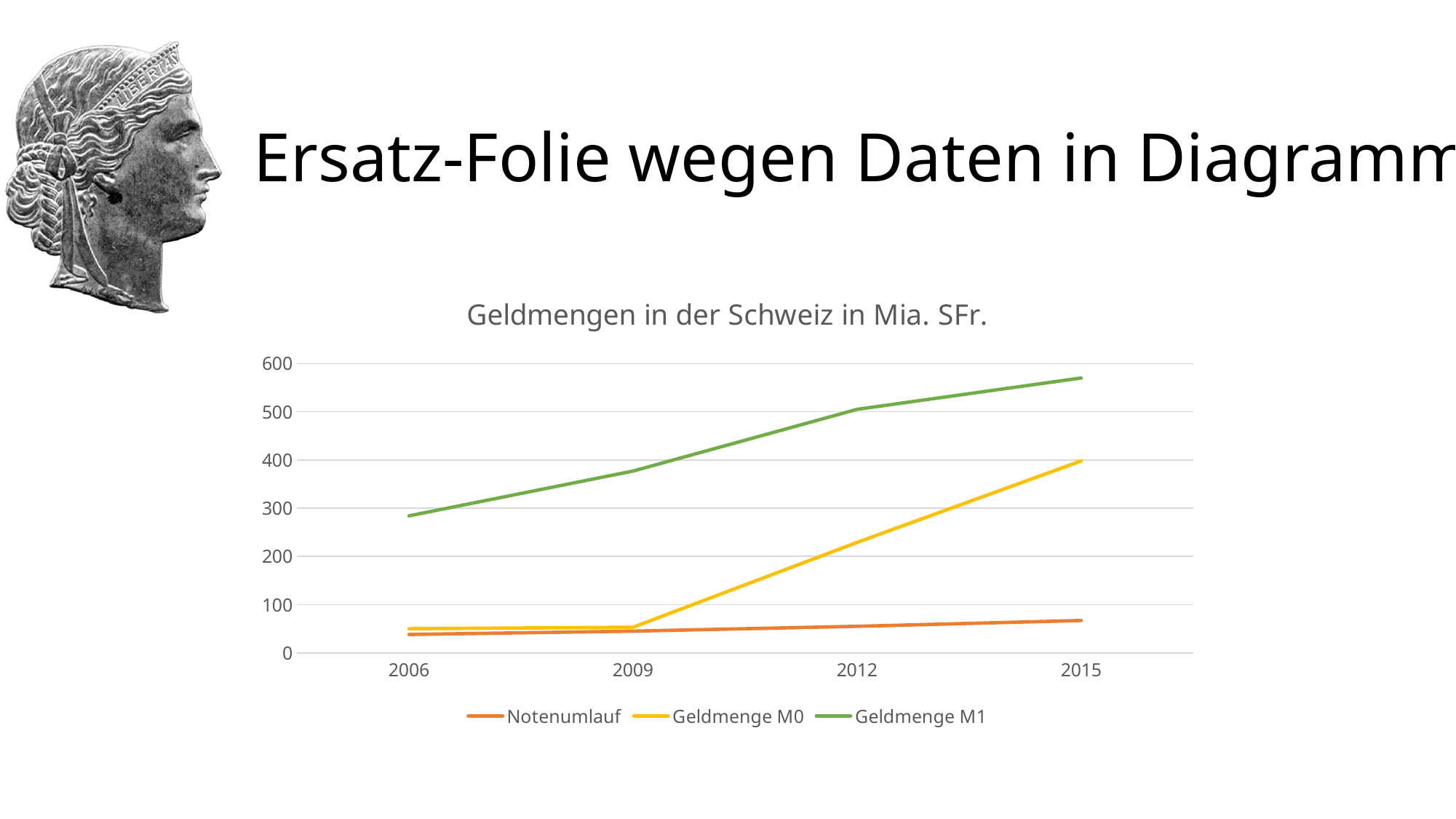
How many years are shown on the x axis? 4 Is the value for Notenumlauf in 2015 greater or less than 100? less Which series is represented by the green line? Geldmenge M1 What kind of chart is shown on the slide? Line chart What is the title of the chart? Geldmengen in der Schweiz in Mia. SFr. Which series has the highest value in 2015? Geldmenge M1 Which series has the lowest value in 2015? Notenumlauf In 2015, which is larger: Geldmenge M0 or Notenumlauf? Geldmenge M0 How many series does the legend list? 3 Is the value for Geldmenge M0 in 2009 greater or less than 100? less Is the value for Geldmenge M1 in 2012 greater or less than 400? greater Does Geldmenge M1 rise or fall from 2006 to 2015? Rise